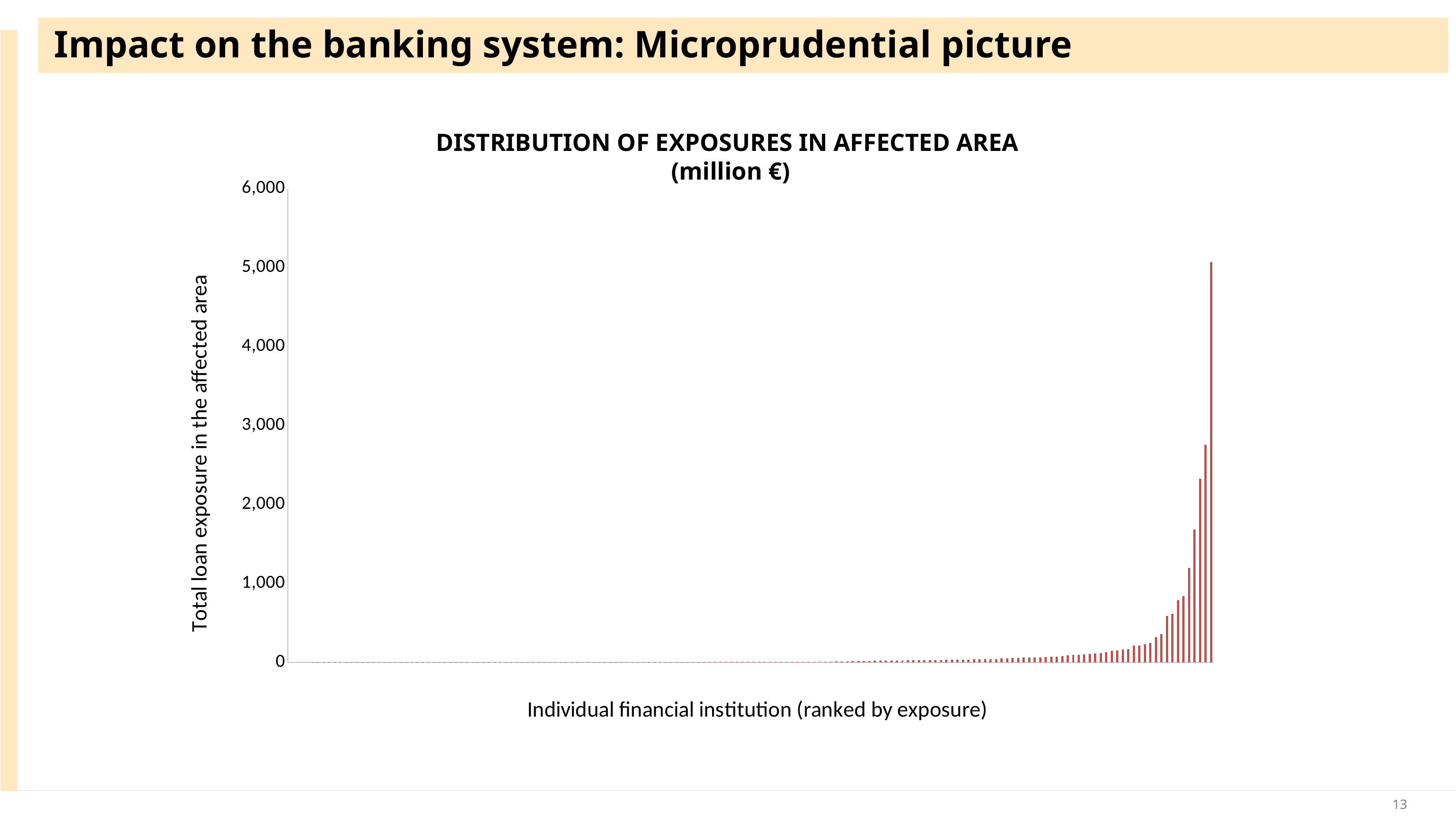
What is the label of the vertical axis of the chart? Total loan exposure in the affected area Is the value of the tallest bar greater or less than 6,000? less What kind of chart is shown on the slide? bar chart Do the bar values rise or fall from left to right along the x axis? rise Is the value of the leftmost bar greater or less than 1,000? less Which bar is larger: the rightmost bar or the bar immediately to its left? the rightmost bar Is the value of the tallest bar greater or less than 4,000? greater What is the title of the chart? DISTRIBUTION OF EXPOSURES IN AFFECTED AREA (million €)